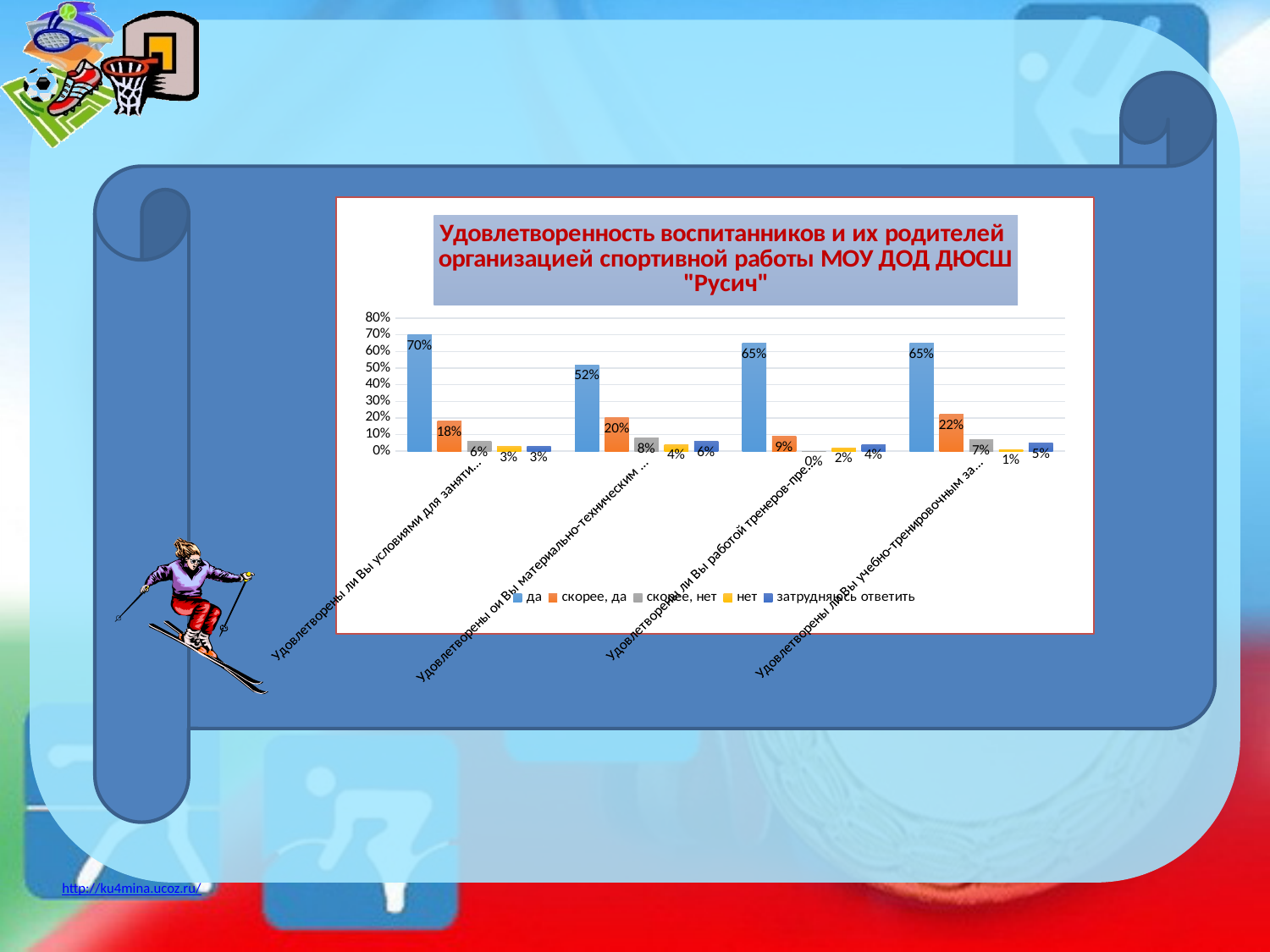
In which category is the "скорее, да" value the highest? Удовлетворены ли Вы учебно-тренировочным за... (fourth category) What is the value of the "да" series for the first category (Удовлетворены ли Вы условиями для занятий...)? 70% How many question categories are shown along the x axis? 4 What type of chart is shown on the slide? bar chart In which category is the "да" value the lowest? Удовлетворены ли Вы материально-техническим ... (second category) What is the value of the "затрудняюсь ответить" series for the fourth category (учебно-тренировочным...)? 5% What is the value of the "скорее, нет" series for the category about работой тренеров (third category)? 0% What is the value of the "скорее, да" series for the category about материально-техническим (second category)? 20% How many series does the legend list? 5 What is the title of the chart? Удовлетворенность воспитанников и их родителей организацией спортивной работы МОУ ДОД ДЮСШ "Русич" What is the difference between the "да" value for the first category (70%) and the "да" value for the second category (52%)? 18% Which is larger: the "нет" value for the second category or the "нет" value for the fourth category? the second category (4%)